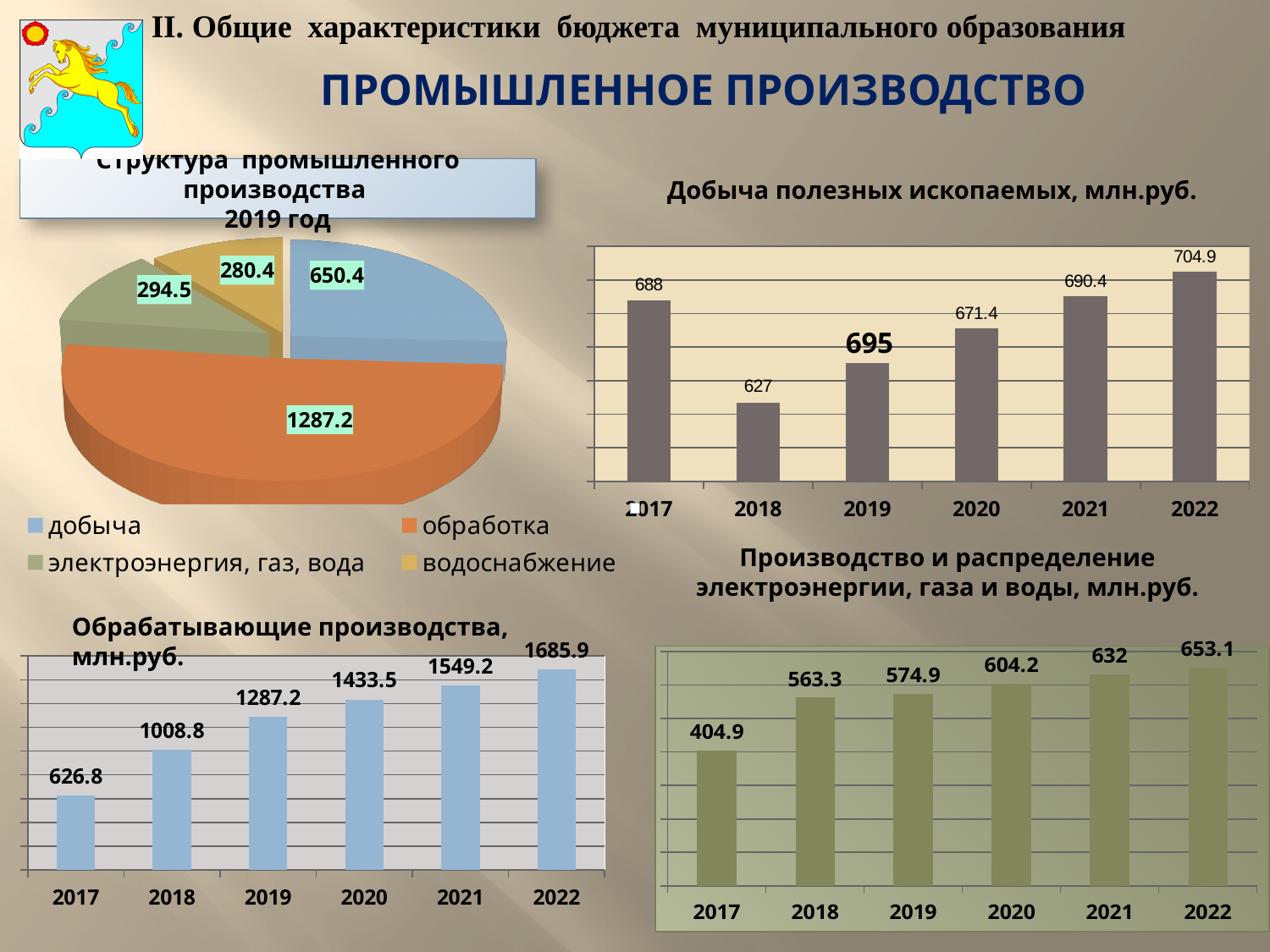
In the chart 'Добыча полезных ископаемых, млн.руб.', which year has the highest value? 2022 In the chart 'Добыча полезных ископаемых, млн.руб.', which year has the lowest value? 2018 In the chart 'Обрабатывающие производства, млн.руб.', do the values rise or fall from 2017 to 2022? rise In the chart 'Обрабатывающие производства, млн.руб.', what is the difference between the 2022 and 2017 values? 1059.1 In the chart 'Добыча полезных ископаемых, млн.руб.', what is the value for 2020? 671.4 In the chart 'Производство и распределение электроэнергии, газа и воды, млн.руб.', what is the value for 2021? 632 In the pie chart 'Структура промышленного производства 2019 год', how many categories does the legend list? 4 In the pie chart 'Структура промышленного производства 2019 год', which category has the largest slice? обработка In the chart 'Обрабатывающие производства, млн.руб.', what is the value for 2018? 1008.8 What kind of chart is 'Обрабатывающие производства, млн.руб.'? bar chart In the chart 'Производство и распределение электроэнергии, газа и воды, млн.руб.', which is larger, the value for 2017 or the value for 2018? 2018 In the pie chart 'Структура промышленного производства 2019 год', what is the value for обработка? 1287.2